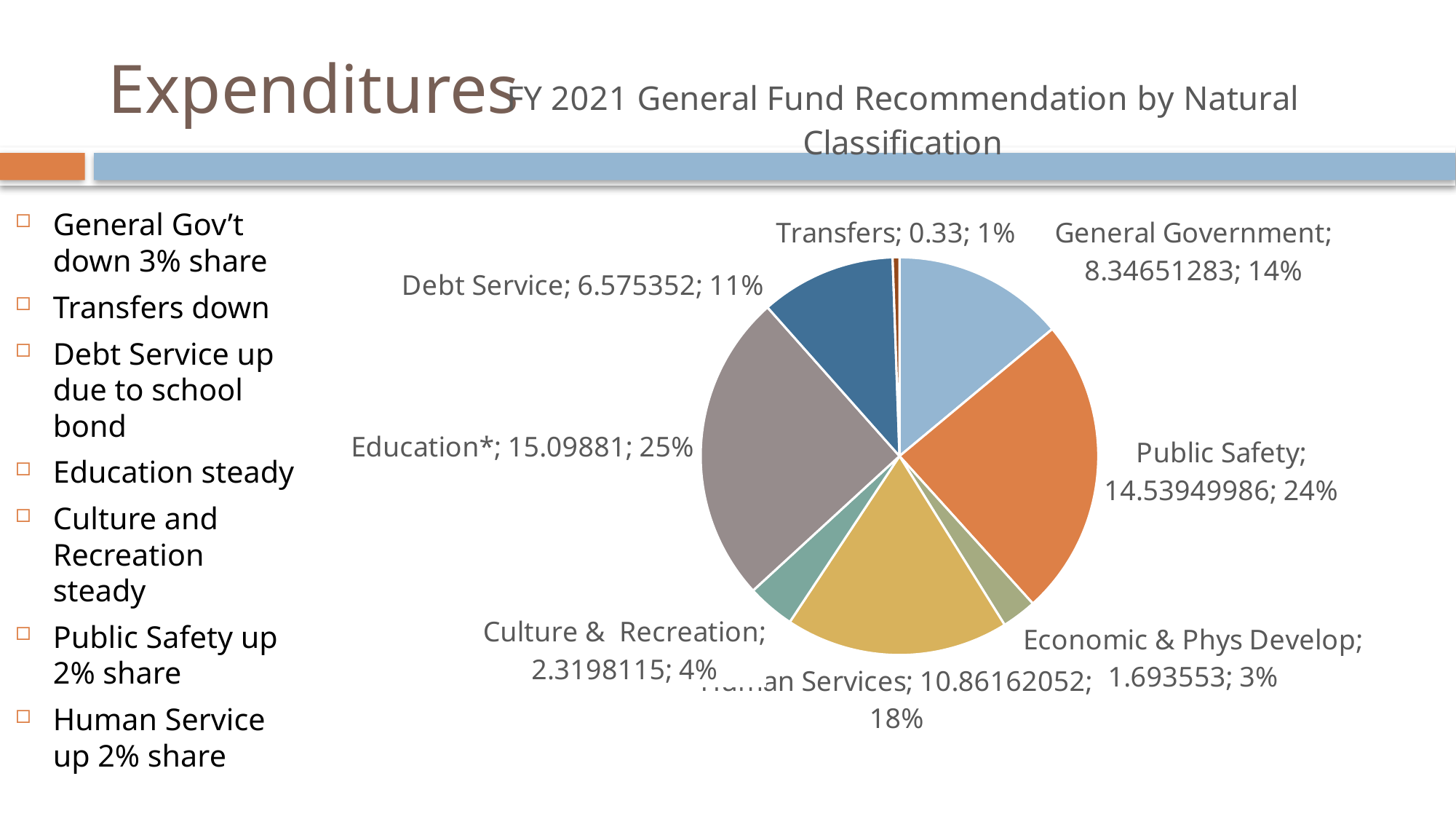
Which is larger, General Government or Debt Service? General Government What value is shown for Public Safety? 14.53949986 How many slices does the pie chart have? 8 What is the title of the chart? FY 2021 General Fund Recommendation by Natural Classification What value is shown for Debt Service? 6.575352 Which category has the smallest slice of the pie? Transfers What is the difference in percentage share between Public Safety and Human Services? 6% Which category has the largest slice of the pie? Education* What share of the pie does Human Services represent? 18% What kind of chart is shown on the slide? Pie chart What value is shown for Economic & Phys Develop? 1.693553 What share of the pie does Education* represent? 25%